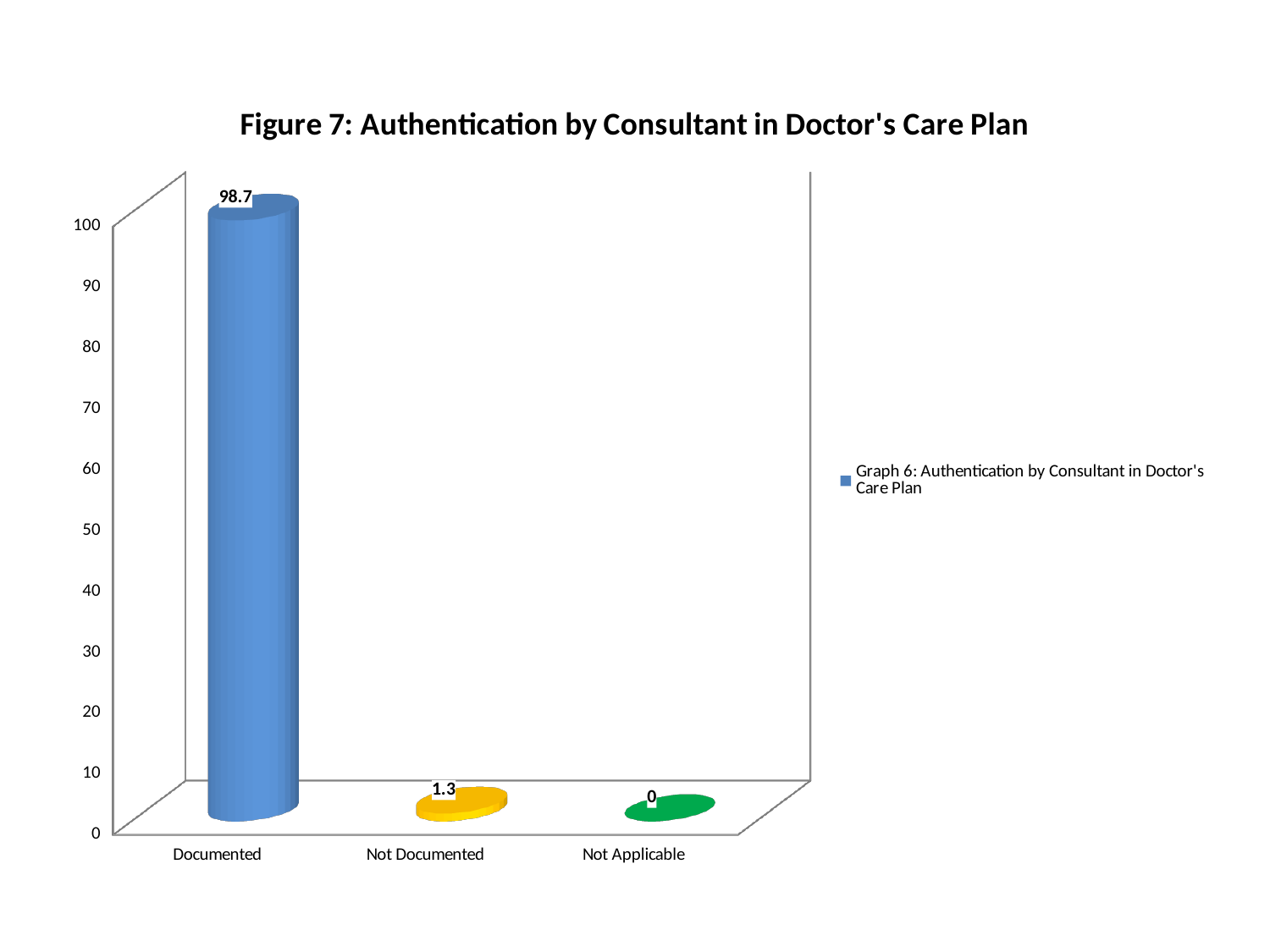
Which is larger, the value for Not Documented or the value for Not Applicable? Not Documented How many categories are shown on the x axis? 3 Which category has the highest value? Documented What is the value for Not Applicable? 0 What is the value for Documented? 98.7 What is the difference between the values for Documented and Not Documented? 97.4 How many series does the legend list? 1 What is the title of the chart? Figure 7: Authentication by Consultant in Doctor's Care Plan Is the value for Documented greater or less than 90? greater Which category has the lowest value? Not Applicable What kind of chart is shown on the slide? Bar chart What is the value for Not Documented? 1.3